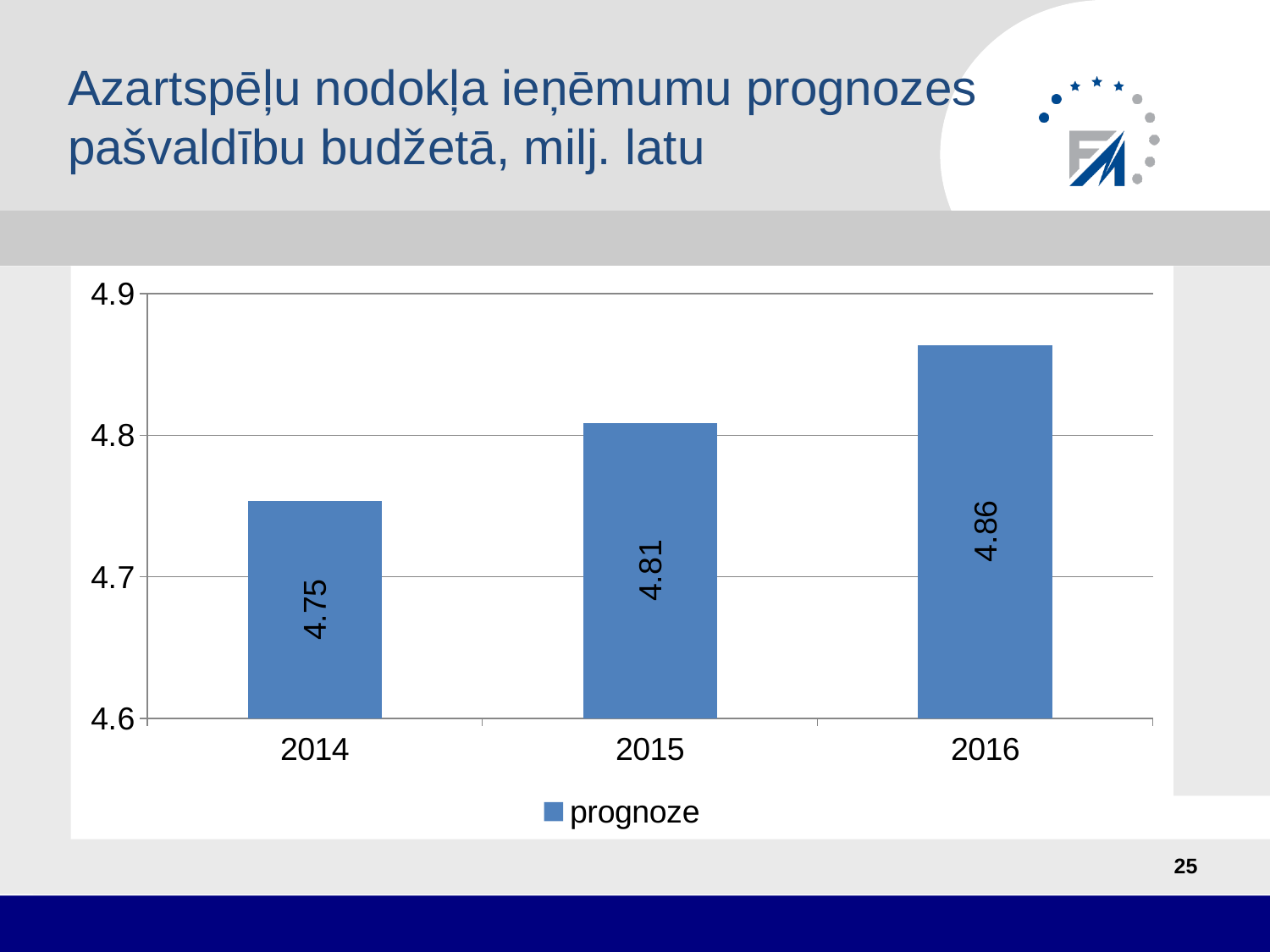
How many years are shown on the x axis? 3 What is the forecast value for 2015? 4.81 Which year has the lowest forecast value? 2014 What kind of chart is shown on the slide? bar chart Is the value for 2016 greater or less than 4.8? greater What is the forecast value for 2014? 4.75 What is the difference between the 2015 and 2014 forecast values? 0.06 Which year has the highest forecast value? 2016 What is the forecast value for 2016? 4.86 Which is larger, the forecast for 2015 or for 2016? 2016 Do the forecast values rise or fall from 2014 to 2016? rise What is the difference between the 2016 and 2014 forecast values? 0.11